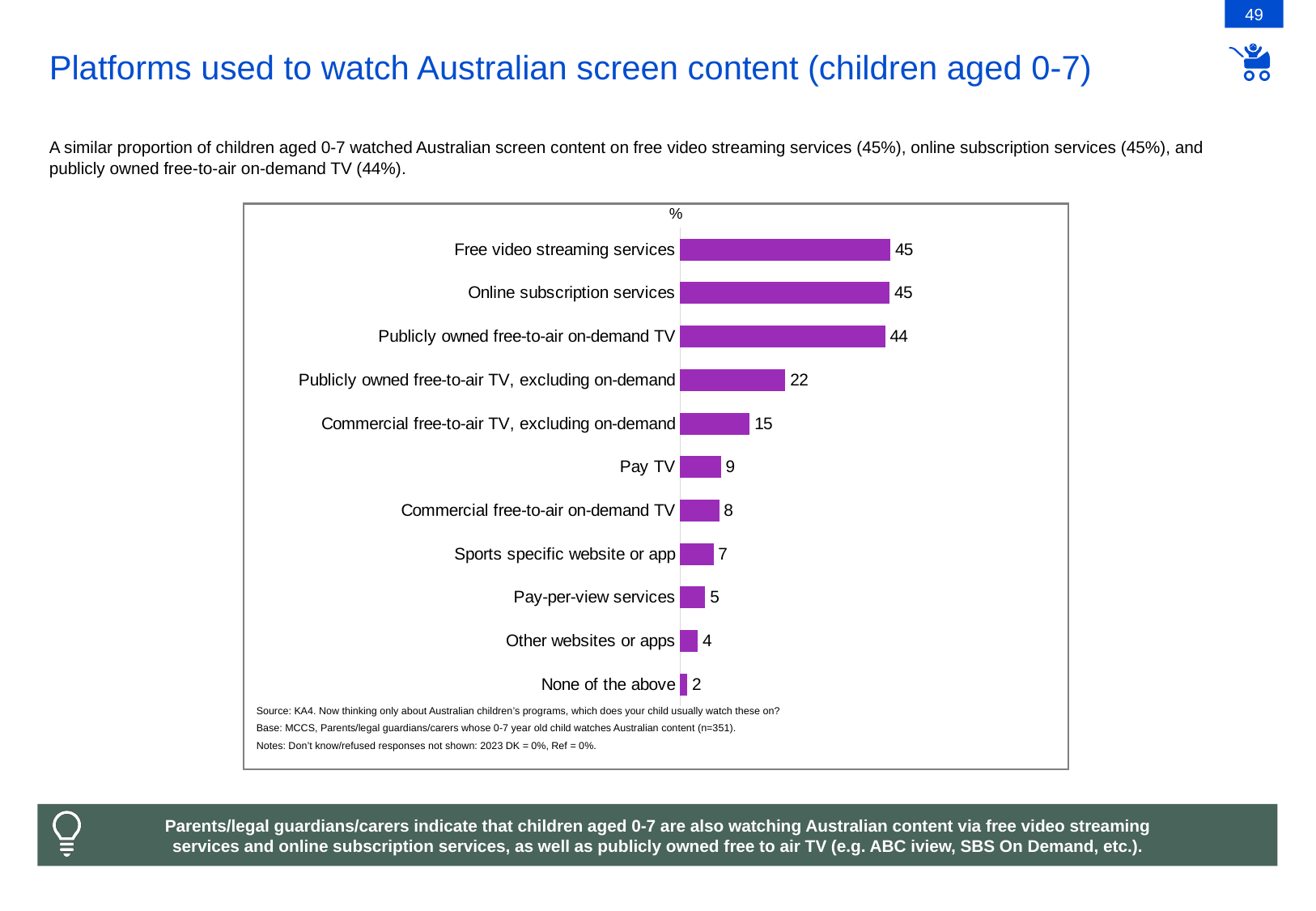
What is the value for Publicly owned free-to-air on-demand TV? 44 What is the value for Pay TV? 9 What is the difference between the values for Free video streaming services and Pay-per-view services? 40 What kind of chart is shown on the slide? Bar chart Which is larger, the value for Publicly owned free-to-air on-demand TV or the value for Publicly owned free-to-air TV, excluding on-demand? Publicly owned free-to-air on-demand TV What is the value for Other websites or apps? 4 Which is larger, the value for Sports specific website or app or the value for Pay-per-view services? Sports specific website or app What is the difference between the values for Publicly owned free-to-air TV, excluding on-demand and Commercial free-to-air TV, excluding on-demand? 7 How many categories are shown in the chart? 11 Which category has the lowest value? None of the above What is the value for Commercial free-to-air TV, excluding on-demand? 15 What colour are the bars in the chart? Purple